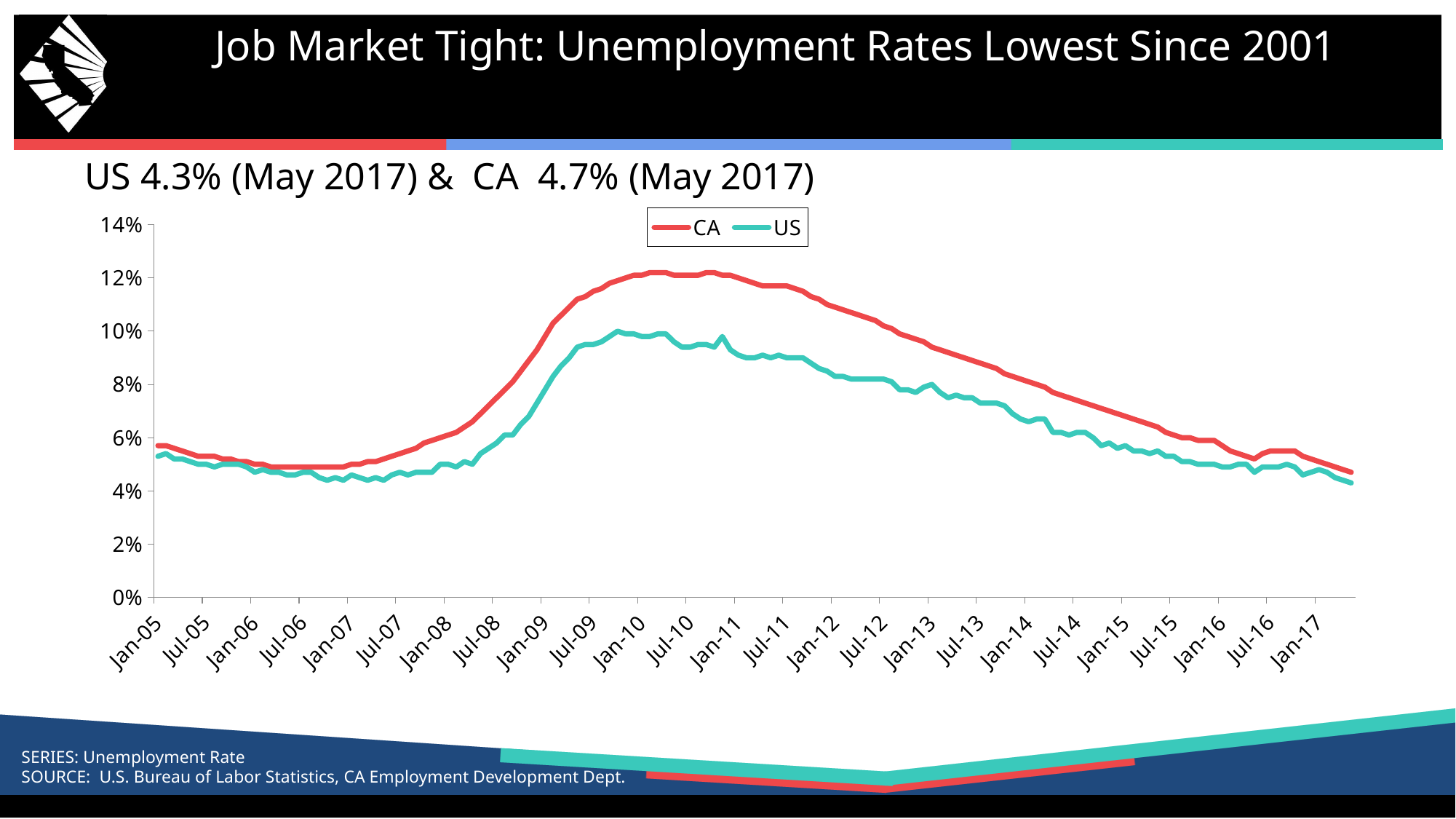
Is the CA unemployment rate at Jan-10 greater or less than 10%? greater How many series does the chart's legend list? 2 Does the CA unemployment rate rise or fall between Jan-10 and Jan-17? fall Which is higher in May 2017, the CA rate or the US rate? CA What kind of chart is shown on the slide? line chart What is the US unemployment rate for May 2017 stated on the slide? 4.3% Which series reaches the higher peak on the chart, CA or US? CA What is the title of the slide containing the chart? Job Market Tight: Unemployment Rates Lowest Since 2001 What is the difference between the CA and US unemployment rates for May 2017? 0.4% Is the US unemployment rate at Jan-07 greater or less than 6%? less What is the CA unemployment rate for May 2017 stated on the slide? 4.7% What are the two series named in the chart legend? CA and US